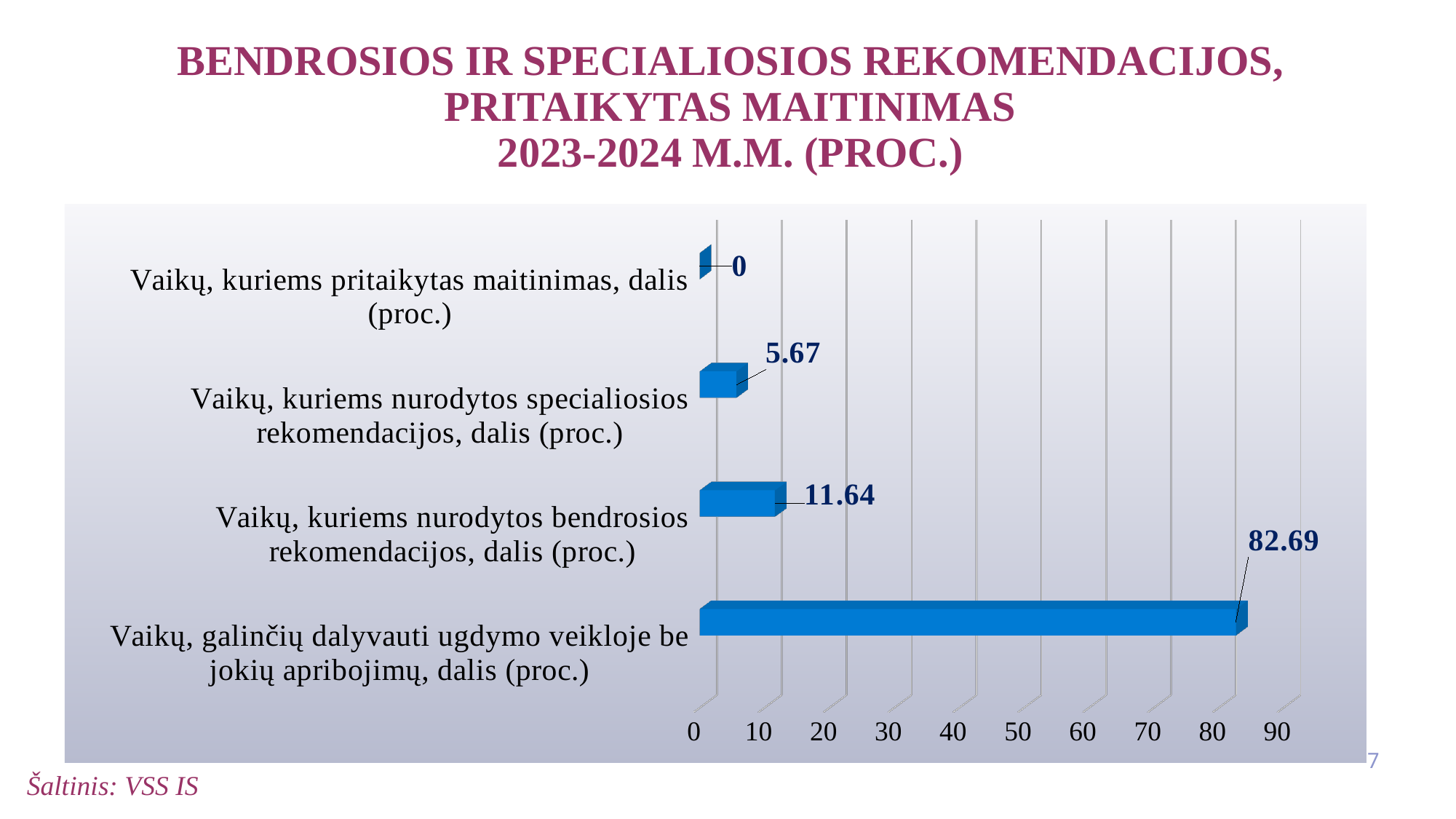
What is the source cited below the chart? VSS IS What is the difference between the value for bendrosios rekomendacijos (11.64) and specialiosios rekomendacijos (5.67)? 5.97 What is the value for "Vaikų, kuriems pritaikytas maitinimas, dalis (proc.)"? 0 Which category has the highest value? Vaikų, galinčių dalyvauti ugdymo veikloje be jokių apribojimų, dalis (proc.) Is the value for "Vaikų, galinčių dalyvauti ugdymo veikloje be jokių apribojimų, dalis (proc.)" greater or less than 80? greater What is the value for "Vaikų, kuriems nurodytos bendrosios rekomendacijos, dalis (proc.)"? 11.64 What is the value for "Vaikų, galinčių dalyvauti ugdymo veikloje be jokių apribojimų, dalis (proc.)"? 82.69 Which is larger: the value for bendrosios rekomendacijos or the value for specialiosios rekomendacijos? Vaikų, kuriems nurodytos bendrosios rekomendacijos, dalis (proc.) Which category has the lowest value? Vaikų, kuriems pritaikytas maitinimas, dalis (proc.) What kind of chart is shown on the slide? bar chart How many categories are shown in the chart? 4 What is the value for "Vaikų, kuriems nurodytos specialiosios rekomendacijos, dalis (proc.)"? 5.67